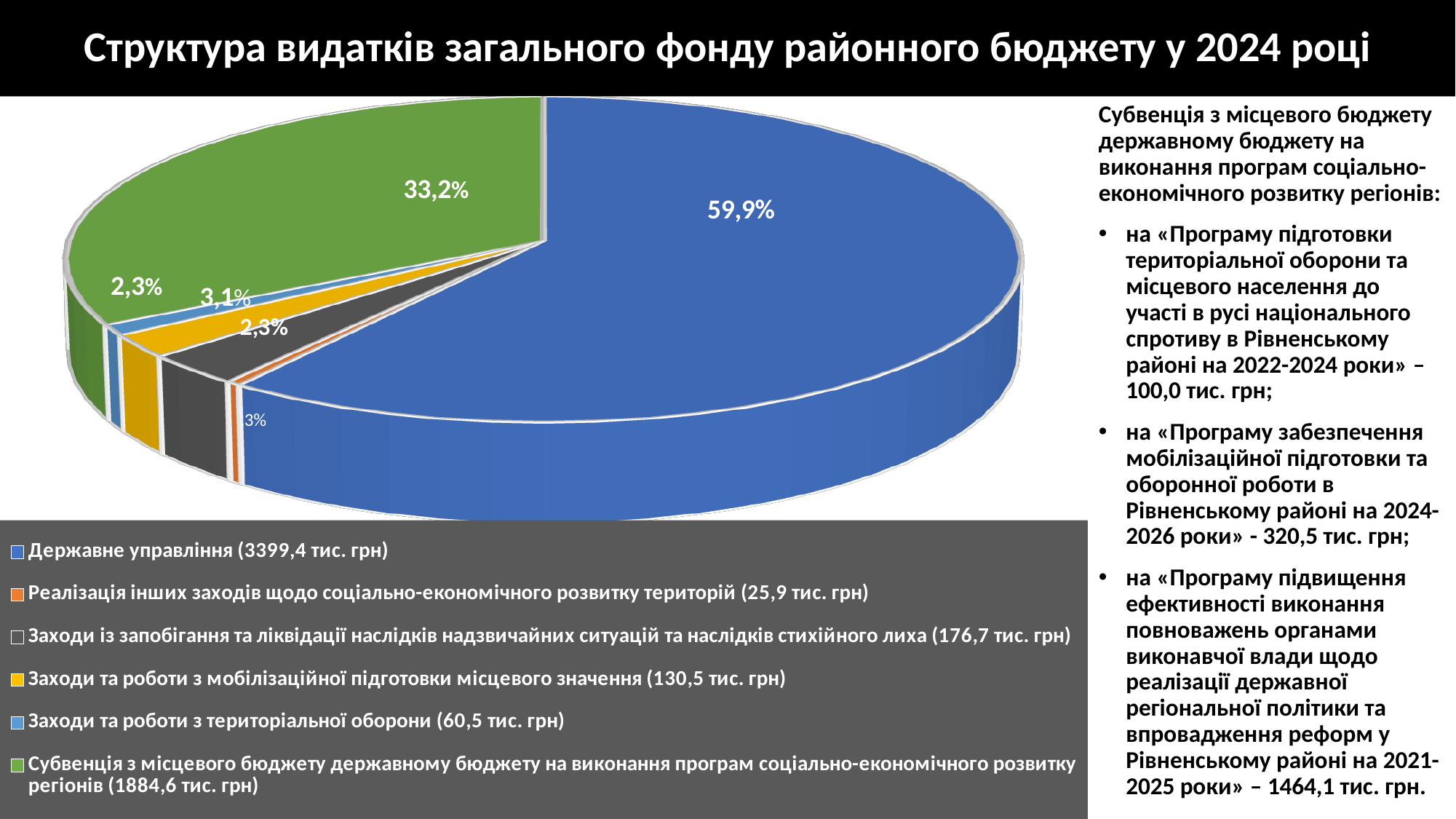
What share of the pie does the slice for «Субвенція з місцевого бюджету державному бюджету на виконання програм соціально-економічного розвитку регіонів» take? 33,2% What amount is shown in the legend for «Державне управління»? 3399,4 тис. грн Which category has the largest value in the pie chart? Державне управління What amount is shown in the legend for «Заходи та роботи з мобілізаційної підготовки місцевого значення»? 130,5 тис. грн What kind of chart is shown on the slide? Pie chart Which category has the smallest value in the pie chart? Реалізація інших заходів щодо соціально-економічного розвитку територій What amount is shown in the legend for «Заходи та роботи з територіальної оборони»? 60,5 тис. грн How many categories (slices) does the pie chart legend list? 6 Which is larger: the amount for «Заходи із запобігання та ліквідації наслідків надзвичайних ситуацій та наслідків стихійного лиха» or for «Заходи та роботи з мобілізаційної підготовки місцевого значення»? Заходи із запобігання та ліквідації наслідків надзвичайних ситуацій та наслідків стихійного лиха What is the title of the chart on the slide? Структура видатків загального фонду районного бюджету у 2024 році What share of the pie does the slice for «Державне управління» take? 59,9% What is the difference between the amounts for «Державне управління» and «Субвенція з місцевого бюджету державному бюджету на виконання програм соціально-економічного розвитку регіонів»? 1514,8 тис. грн